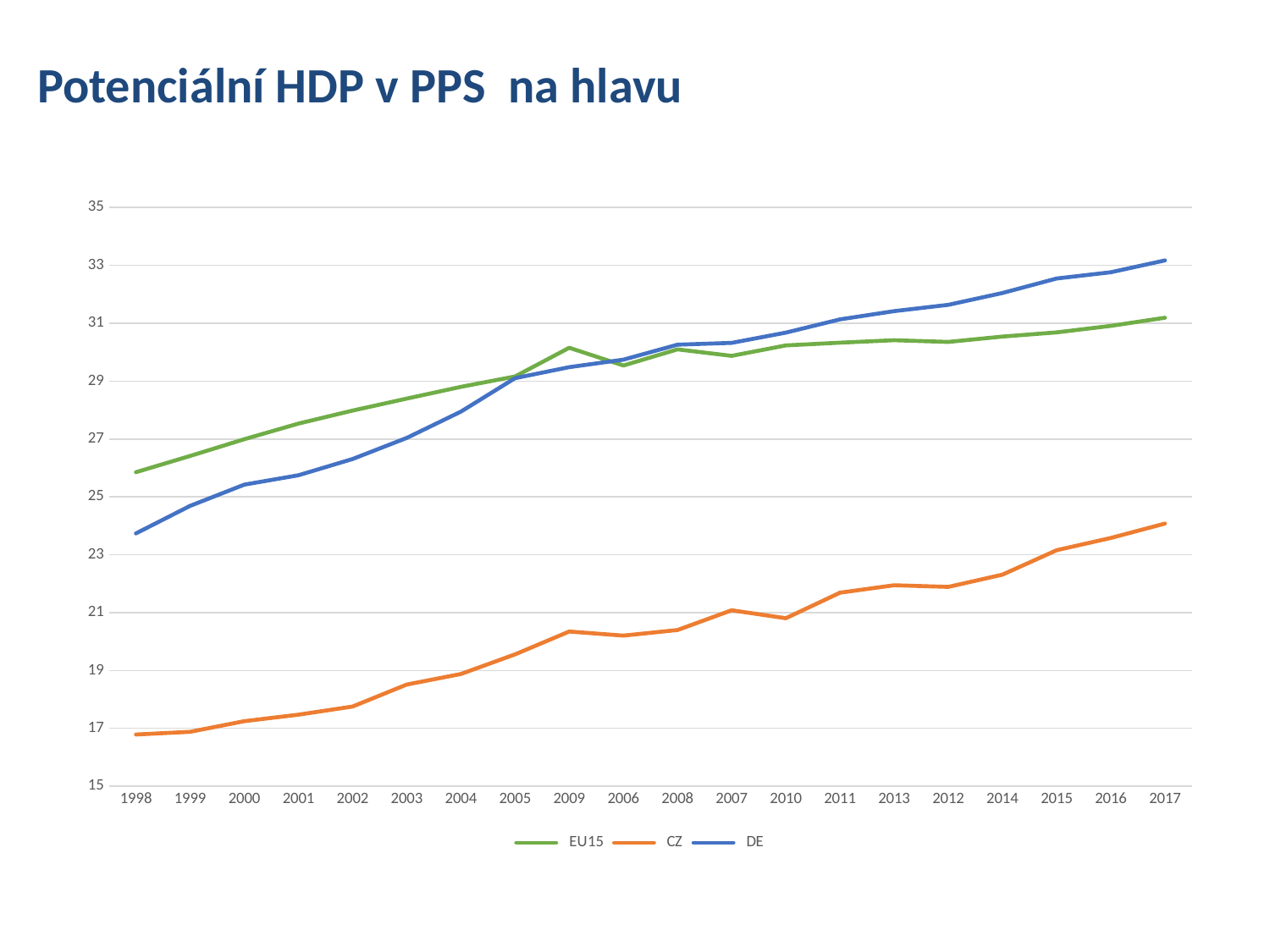
Is the value for CZ in 2010 greater or less than 23? less Which series is larger in 1998, EU15 or DE? EU15 How many series does the legend list? 3 Is the value for CZ in 2017 greater or less than 23? greater What kind of chart is shown on the slide? line chart Which series is larger in 2017, EU15 or DE? DE How many years are shown along the x axis? 20 Which series has the lowest value in 1998? CZ Is the value for DE in 1998 greater or less than 25? less What is the title of the chart? Potenciální HDP v PPS na hlavu Does the CZ series generally rise or fall from 1998 to 2017? rise Which series has the highest value in 2017? DE